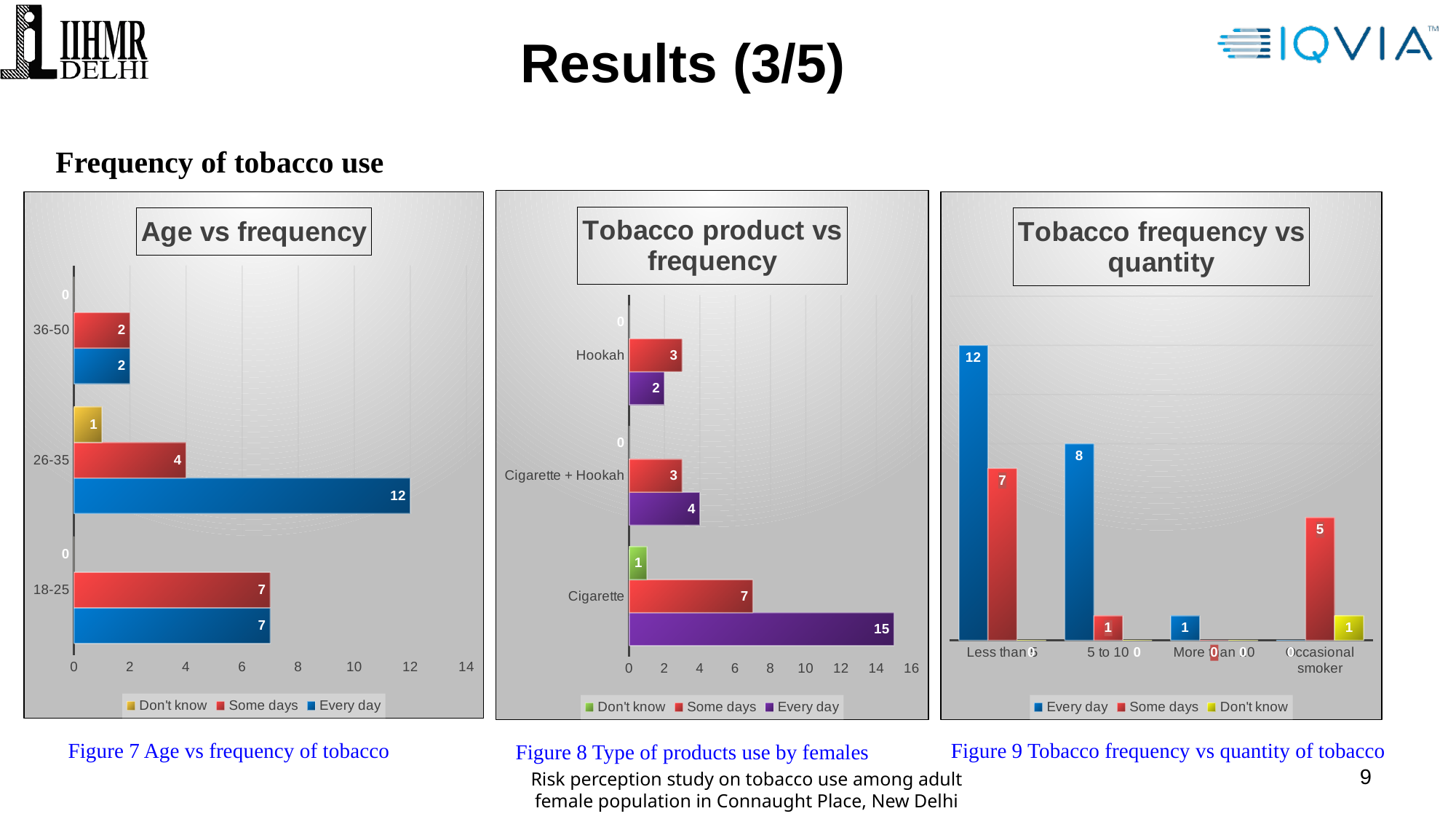
What type of chart is the 'Tobacco frequency vs quantity' chart? Bar chart In the 'Age vs frequency' chart, what is the difference between the Every day and Some days values for the 26-35 age group? 8 In the 'Tobacco product vs frequency' chart, what is the Every day value for Cigarette? 15 In the 'Tobacco frequency vs quantity' chart, which is larger: the Some days value for 'Occasional smoker' or the Some days value for '5 to 10'? Occasional smoker In the 'Age vs frequency' chart, what is the Some days value for the 18-25 age group? 7 In the 'Tobacco product vs frequency' chart, which product has the lowest Every day value? Hookah In the 'Age vs frequency' chart, what is the Every day value for the 26-35 age group? 12 In the 'Tobacco product vs frequency' chart, how many product categories are shown? 3 In the 'Tobacco frequency vs quantity' chart, what is the Every day value for 'Less than 5'? 12 In the 'Tobacco product vs frequency' chart, what is the Some days value for Hookah? 3 In the 'Age vs frequency' chart, which age group has the highest Every day value? 26-35 In the 'Age vs frequency' chart, how many series does the legend list? 3